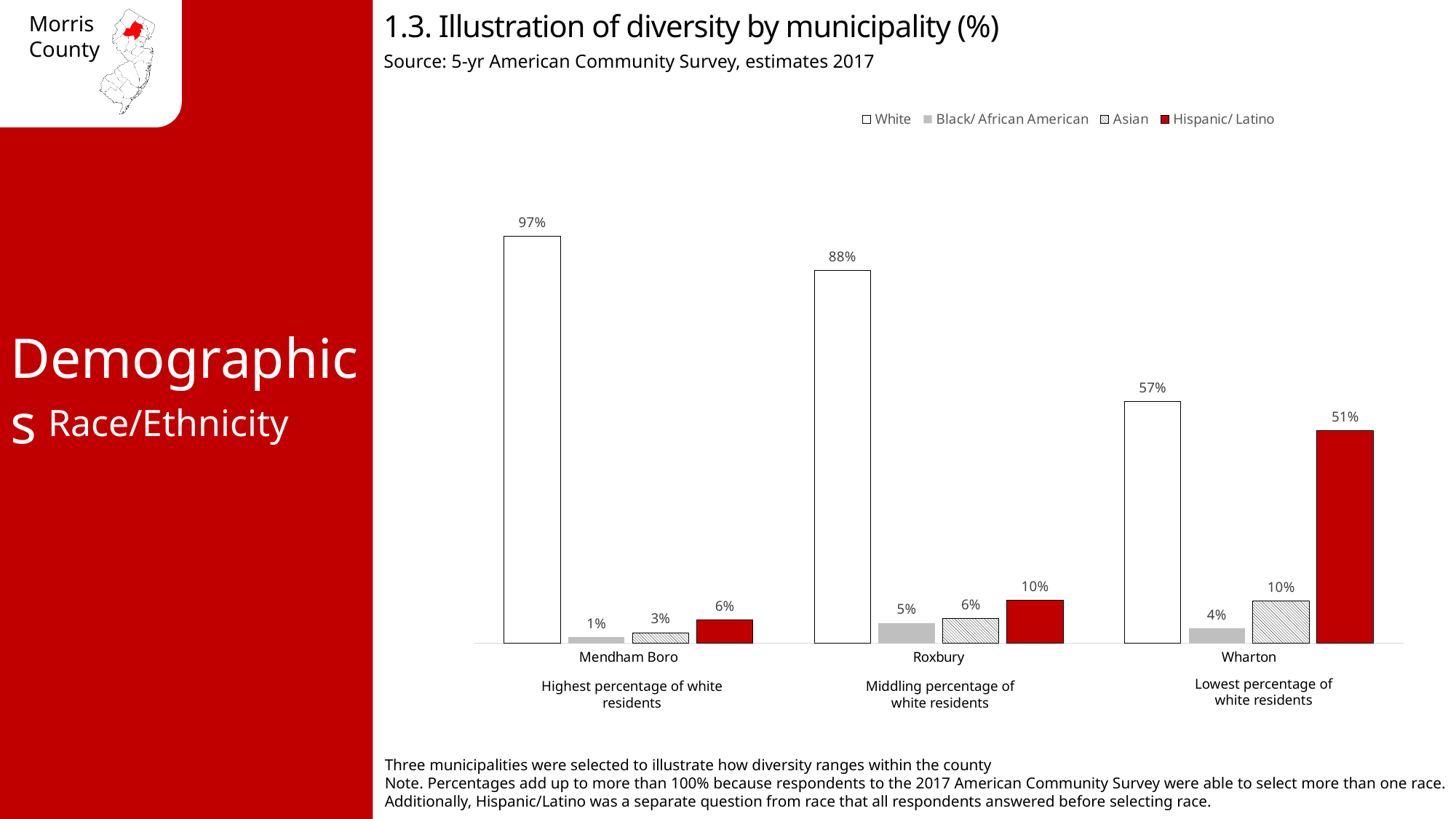
What is the Black/African American percentage for Wharton? 4% What is the difference between the White percentage in Mendham Boro and in Wharton? 40% What kind of chart is shown on the slide? Bar chart What percentage of Mendham Boro residents are White? 97% What is the Asian percentage for Roxbury? 6% What is the Hispanic/Latino percentage for Wharton? 51% Which series is shown in red on the chart? Hispanic/ Latino How many municipalities are shown on the chart? 3 Which is larger: the Asian percentage in Wharton or the Asian percentage in Mendham Boro? Wharton How many series does the legend list? 4 Which municipality has the lowest Hispanic/Latino percentage? Mendham Boro Which municipality has the highest White percentage? Mendham Boro